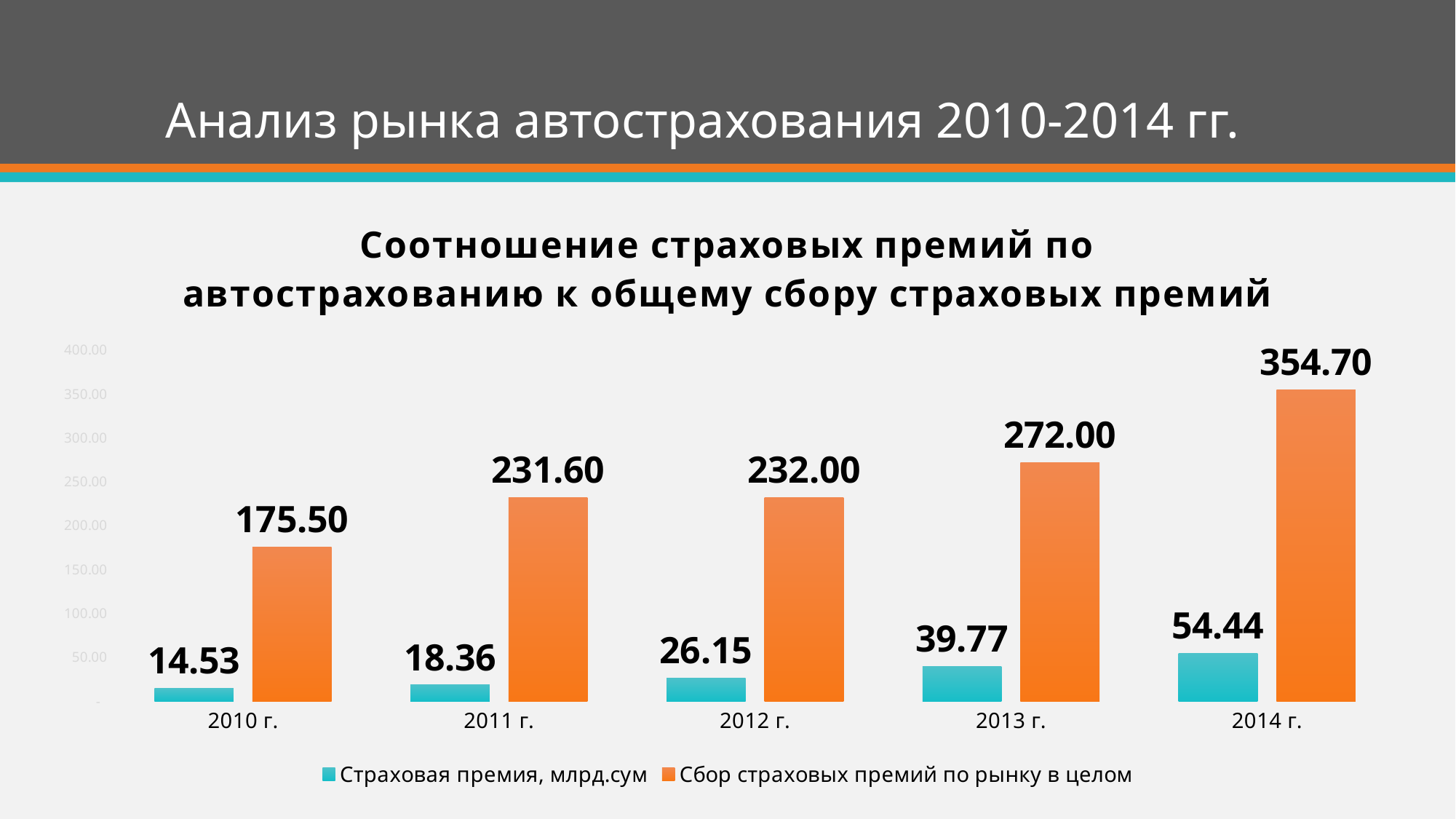
Which is larger: 'Страховая премия, млрд.сум' for 2013 г. or for 2012 г.? 2013 г. What is the difference between the 'Сбор страховых премий по рынку в целом' values for 2014 г. and 2013 г.? 82.70 What is the value of 'Сбор страховых премий по рынку в целом' for 2014 г.? 354.70 How many years are shown on the x axis? 5 What is the value of 'Сбор страховых премий по рынку в целом' for 2012 г.? 232.00 Do the values of 'Страховая премия, млрд.сум' rise or fall from 2010 г. to 2014 г.? rise Which year has the lowest value for 'Сбор страховых премий по рынку в целом'? 2010 г. What kind of chart is shown on the slide? bar chart What is the value of 'Страховая премия, млрд.сум' for 2010 г.? 14.53 Is the value of 'Сбор страховых премий по рынку в целом' for 2011 г. greater or less than 200.00? greater Which year has the highest value for 'Страховая премия, млрд.сум'? 2014 г. How many series does the legend list? 2